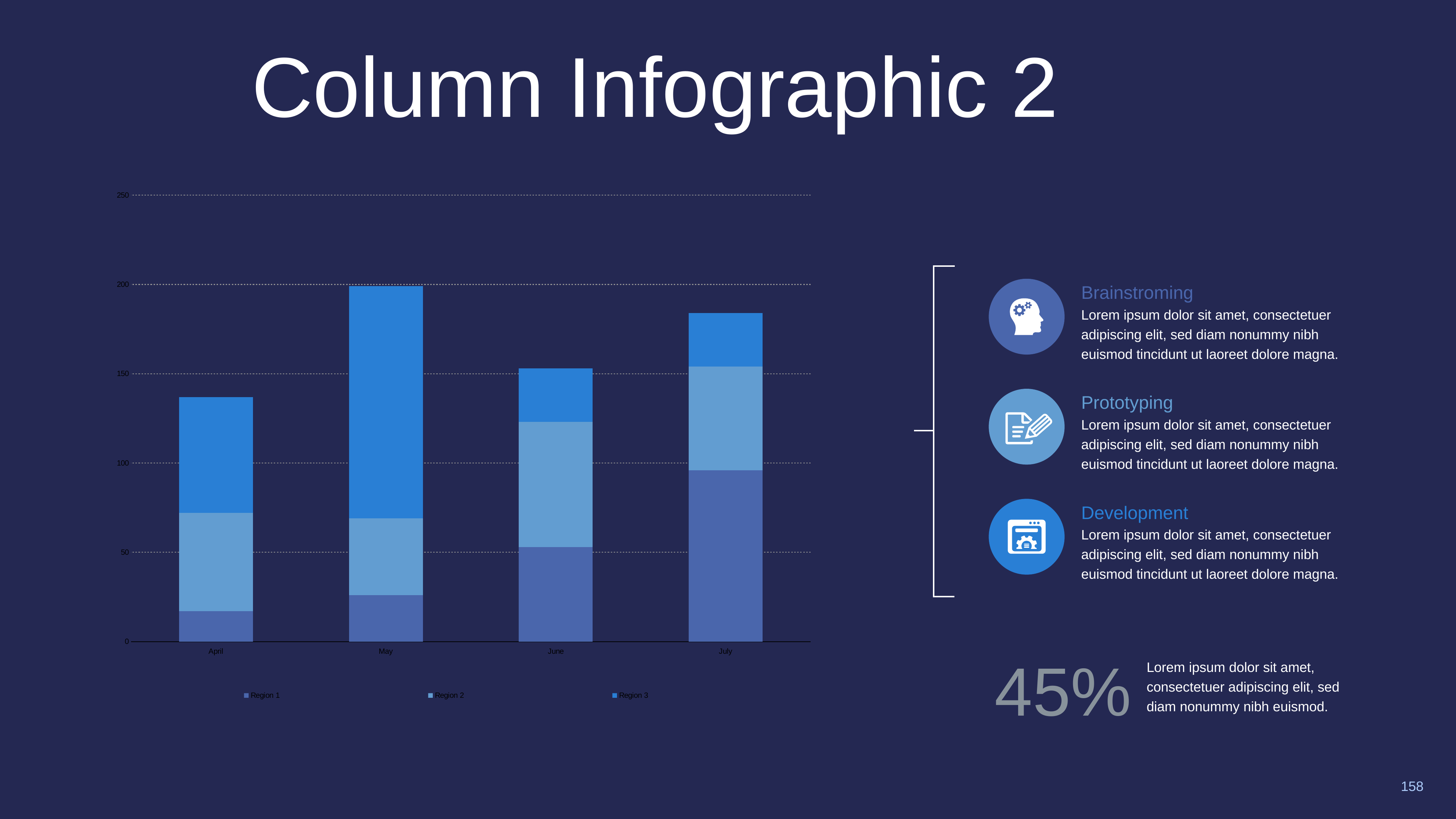
Which month has the shortest stacked bar? April Which has the larger total stacked value, June or July? July Is the Region 1 value for July greater or less than 50? greater Which month has the tallest stacked bar? May Is the Region 1 value for April greater or less than 50? less Is the total stacked value for April greater or less than 150? less What are the names of the series listed in the chart's legend? Region 1, Region 2, Region 3 How many categories are shown on the x axis of the chart? 4 What kind of chart is shown on the slide? Stacked bar chart How many series does the chart's legend list? 3